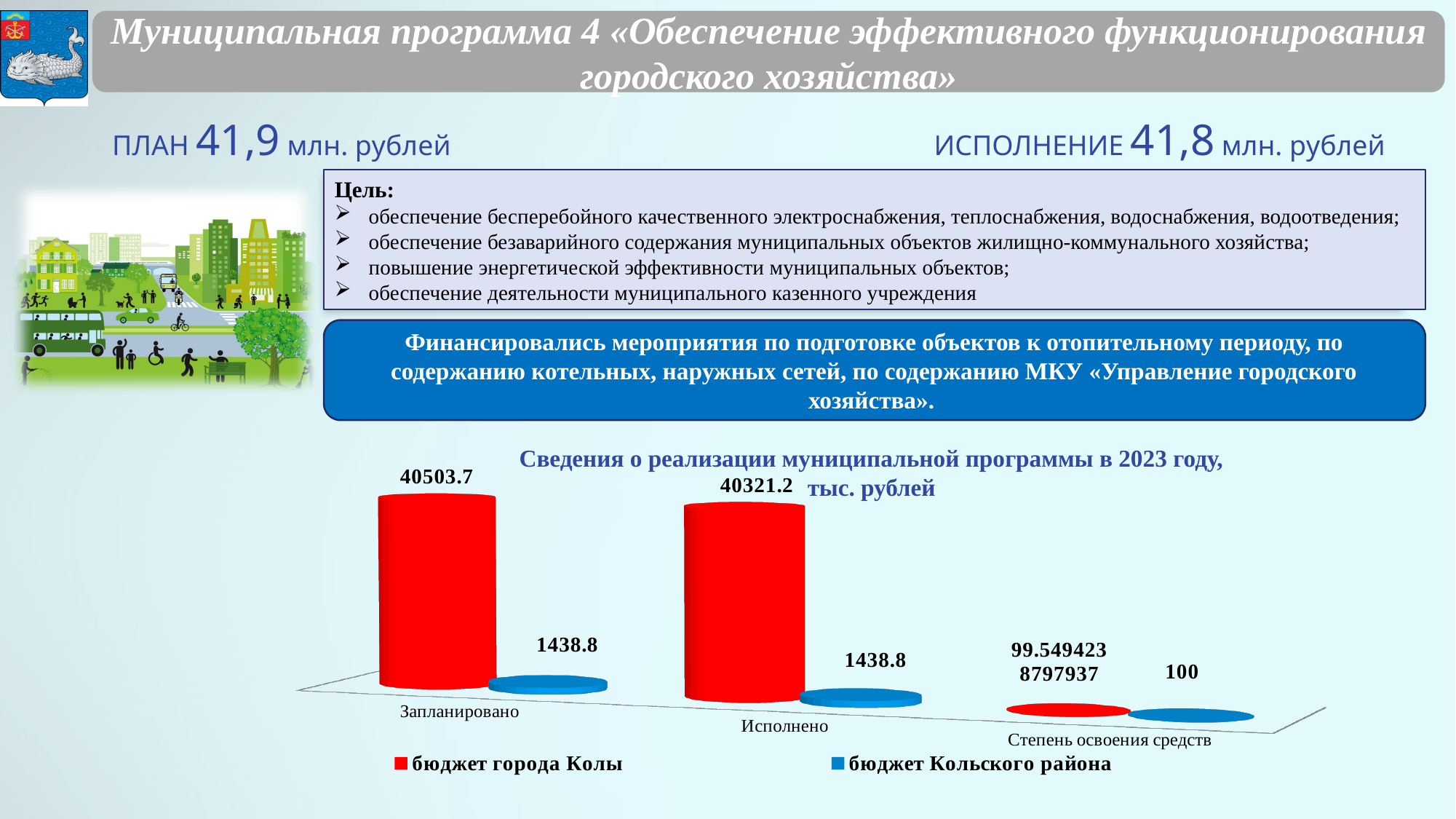
What is the difference between the бюджет города Колы values for Запланировано and Исполнено? 182.5 How many categories are shown on the x axis of the chart? 3 What is the value for бюджет города Колы in the Исполнено category? 40321.2 What is the title of the chart? Сведения о реализации муниципальной программы в 2023 году, тыс. рублей Which colour represents бюджет Кольского района in the chart? blue What is the value for бюджет города Колы in the Запланировано category? 40503.7 How many series does the chart legend list? 2 What type of chart is shown on the slide? bar chart Which is larger in the Исполнено category: бюджет города Колы or бюджет Кольского района? бюджет города Колы What is the value for бюджет Кольского района in the Запланировано category? 1438.8 In which category is the бюджет города Колы value the highest? Запланировано What is the value for бюджет Кольского района in the Степень освоения средств category? 100